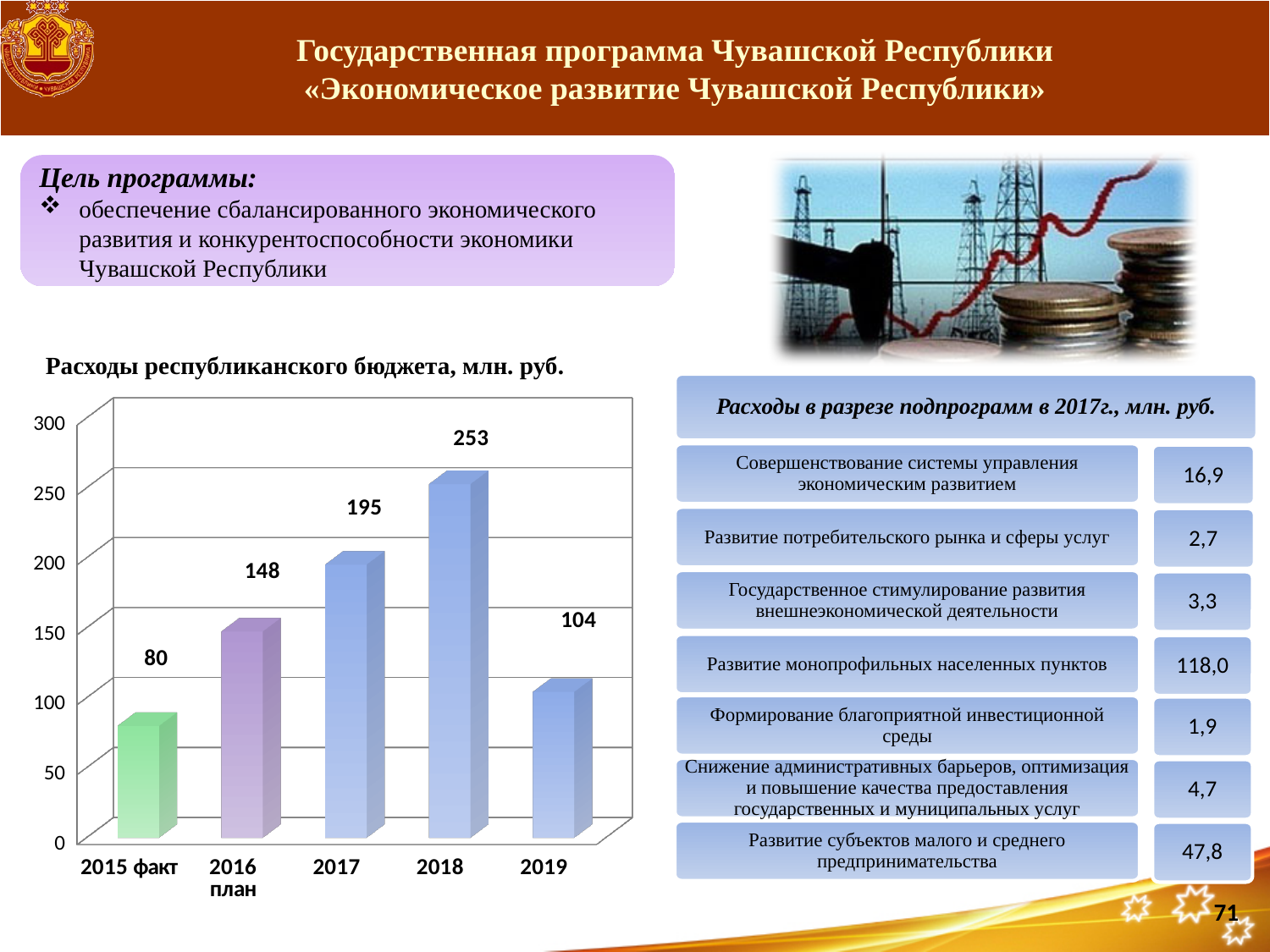
What kind of chart is 'Расходы республиканского бюджета, млн. руб.'? bar chart Which category has the lowest value in the chart 'Расходы республиканского бюджета, млн. руб.'? 2015 факт How many categories are shown on the x axis of the chart 'Расходы республиканского бюджета, млн. руб.'? 5 Is the value for 2016 план greater or less than 150 in the chart 'Расходы республиканского бюджета, млн. руб.'? less Which is larger in the chart 'Расходы республиканского бюджета, млн. руб.': the value for 2017 or the value for 2019? 2017 Do the values rise or fall from 2015 факт to 2018 in the chart 'Расходы республиканского бюджета, млн. руб.'? rise What is the value for 2019 in the chart 'Расходы республиканского бюджета, млн. руб.'? 104 What is the value for 2018 in the chart 'Расходы республиканского бюджета, млн. руб.'? 253 What is the value for 2015 факт in the chart 'Расходы республиканского бюджета, млн. руб.'? 80 What is the difference between the values for 2018 and 2017 in the chart 'Расходы республиканского бюджета, млн. руб.'? 58 Which category has the highest value in the chart 'Расходы республиканского бюджета, млн. руб.'? 2018 What is the difference between the values for 2016 план and 2015 факт in the chart 'Расходы республиканского бюджета, млн. руб.'? 68